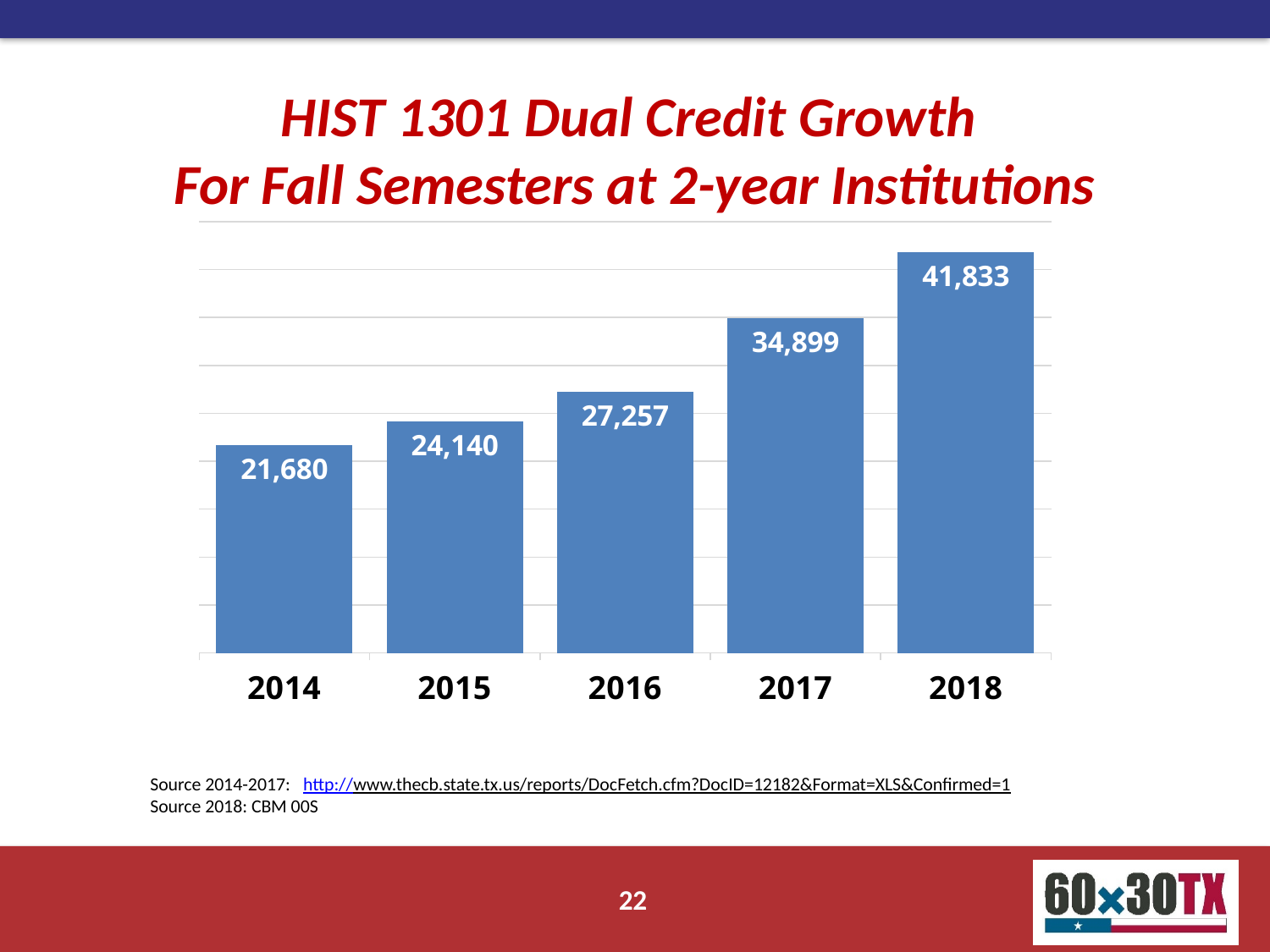
Which year has the lowest value? 2014 What is the value for 2018? 41,833 Do the values rise or fall from 2014 to 2018? rise What is the difference between the values for 2015 and 2014? 2,460 Which year has the highest value? 2018 Which is larger, the value for 2016 or the value for 2017? 2017 What is the difference between the values for 2018 and 2017? 6,934 What is the value for 2014? 21,680 How many years are shown on the x axis? 5 What kind of chart is shown on the slide? bar chart What is the title of the chart? HIST 1301 Dual Credit Growth For Fall Semesters at 2-year Institutions What is the value for 2016? 27,257